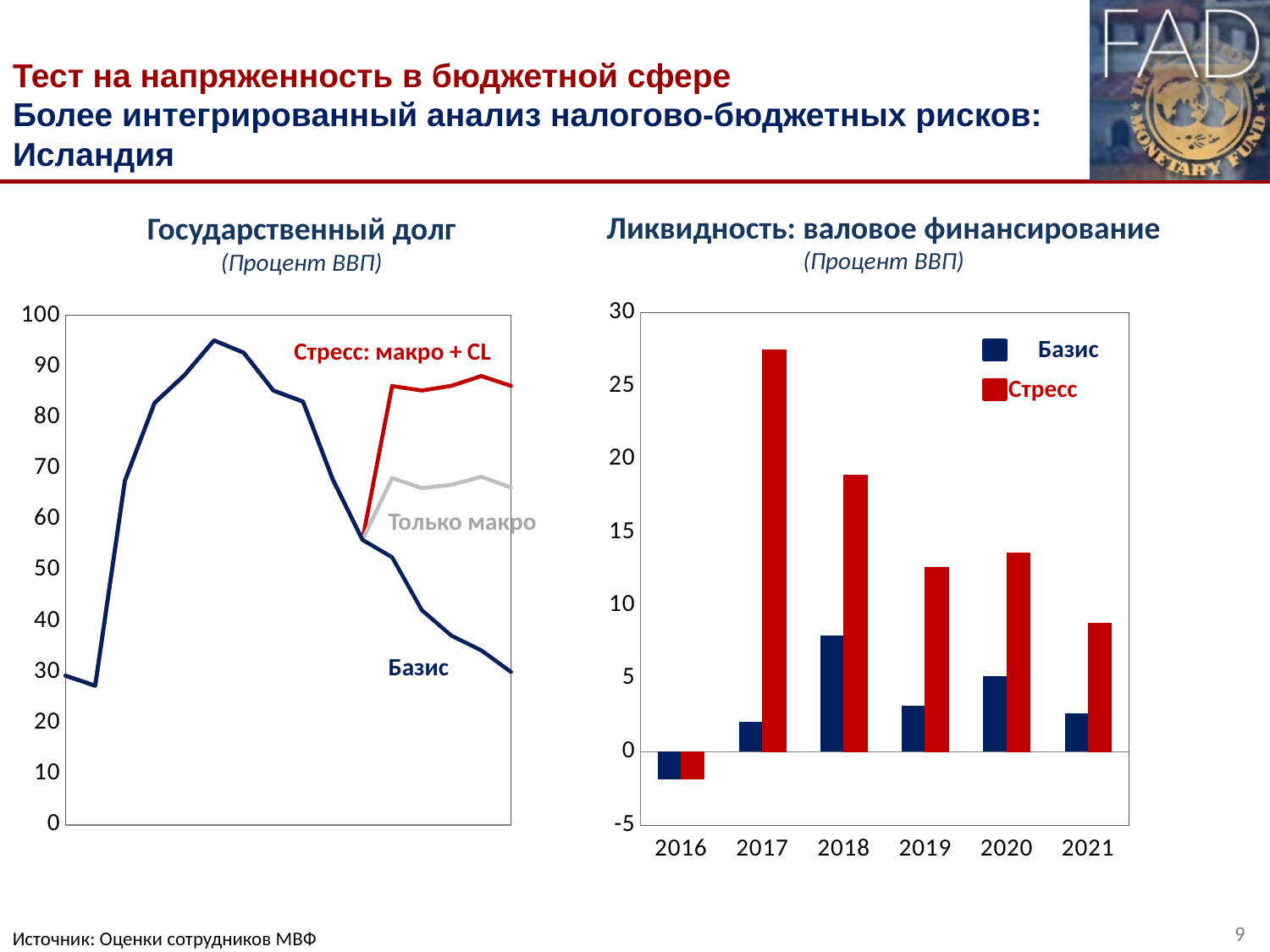
In the 'Ликвидность: валовое финансирование' chart, in which year is the Стресс value highest? 2017 In the 'Ликвидность: валовое финансирование' chart, is the Базис value for 2016 greater or less than 0? less In the 'Ликвидность: валовое финансирование' chart, how many series does the legend list? 2 In the 'Государственный долг' chart, is the peak of the Базис line greater or less than 90? greater In the 'Ликвидность: валовое финансирование' chart, how many years are shown on the x axis? 6 In the 'Ликвидность: валовое финансирование' chart, is the Базис value for 2018 greater or less than 10? less What kind of chart is the left-hand chart, 'Государственный долг'? line chart In the 'Государственный долг' chart, which line ends highest at the right-hand end of the chart? Стресс: макро + CL What kind of chart is the right-hand chart, 'Ликвидность: валовое финансирование'? bar chart In the 'Ликвидность: валовое финансирование' chart, in which year is the Базис value highest? 2018 In the 'Ликвидность: валовое финансирование' chart, which series has the larger value in 2019, Базис or Стресс? Стресс